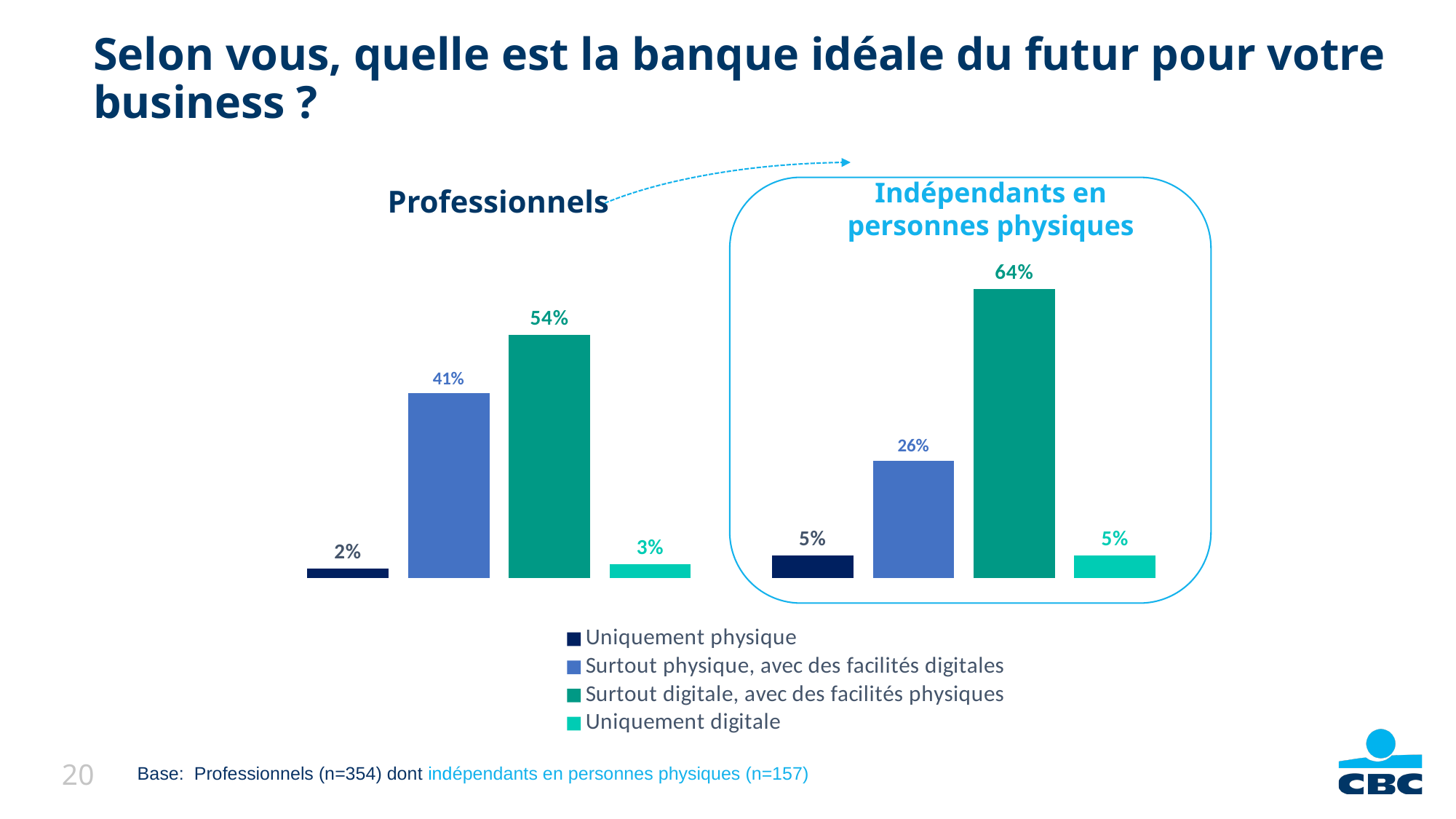
How many series does the legend list? 4 How many groups of bars are shown in the chart? 2 What is the value for "Surtout physique, avec des facilités digitales" in the Indépendants en personnes physiques group? 26% What type of chart is shown on the slide? Bar chart What is the difference between the "Surtout digitale, avec des facilités physiques" values for Indépendants en personnes physiques and Professionnels? 10 percentage points What is the value for "Uniquement physique" in the Professionnels group? 2% Which option has the lowest value in the Professionnels group? Uniquement physique Which option has the highest value in the Indépendants en personnes physiques group? Surtout digitale, avec des facilités physiques What is the difference between "Surtout digitale, avec des facilités physiques" and "Surtout physique, avec des facilités digitales" in the Professionnels group? 13 percentage points What is the value for "Surtout digitale, avec des facilités physiques" in the Professionnels group? 54% What is the value for "Uniquement digitale" in the Indépendants en personnes physiques group? 5% Which is larger: "Surtout physique, avec des facilités digitales" for Professionnels or for Indépendants en personnes physiques? Professionnels